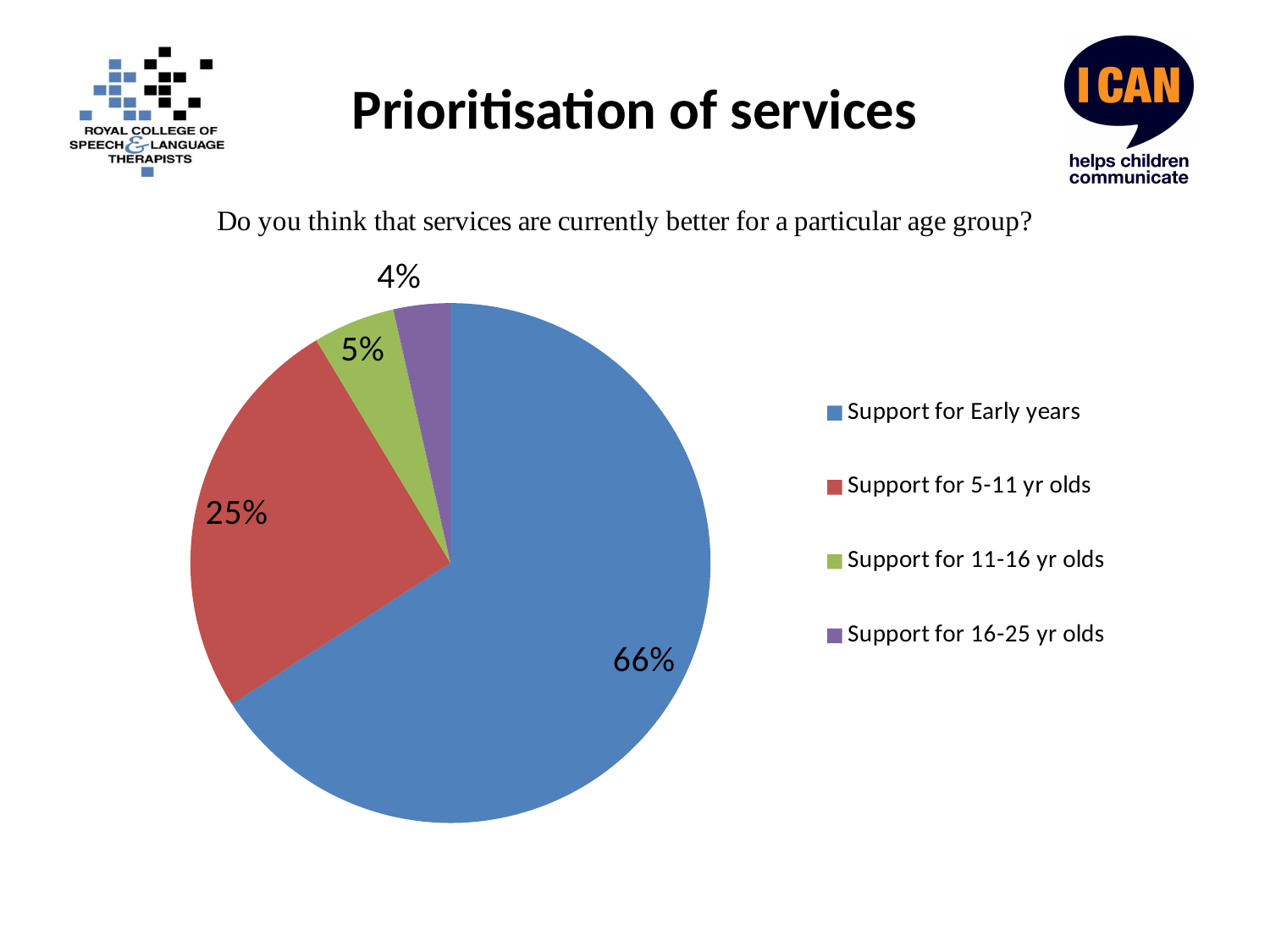
Which is larger: the share for Support for 5-11 yr olds or the share for Support for 11-16 yr olds? Support for 5-11 yr olds What colour is the slice for Support for 11-16 yr olds? green What percentage of the pie is for Support for 11-16 yr olds? 5% Which category has the largest share of the pie? Support for Early years What percentage of the pie is for Support for 16-25 yr olds? 4% Which category has the smallest share of the pie? Support for 16-25 yr olds What is the difference in percentage points between Support for Early years and Support for 5-11 yr olds? 41 What question is the pie chart answering, as written above it? Do you think that services are currently better for a particular age group? What type of chart is shown on the slide? pie chart How many categories does the pie chart show? 4 What percentage of the pie is for Support for 5-11 yr olds? 25% What percentage of the pie is for Support for Early years? 66%